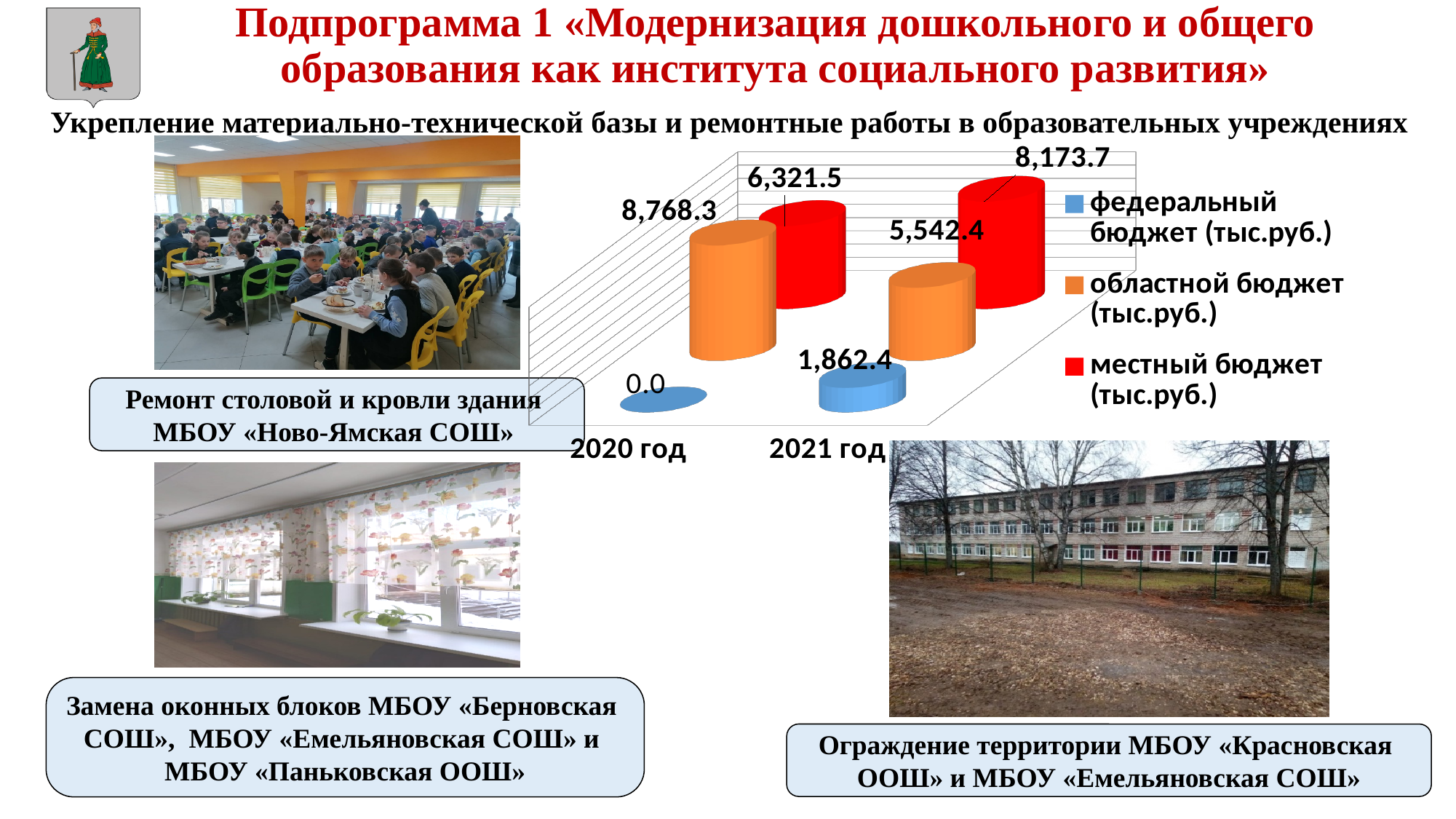
What is the value for федеральный бюджет (тыс.руб.) in 2020 год? 0.0 How many series does the chart legend list? 3 How many year categories are shown on the chart's x axis? 2 What is the value for местный бюджет (тыс.руб.) in 2020 год? 6,321.5 What is the difference between the областной бюджет values for 2020 год and 2021 год? 3,225.9 What is the value for местный бюджет (тыс.руб.) in 2021 год? 8,173.7 Which budget series has the lowest value in 2020 год? федеральный бюджет (тыс.руб.) What is the value for областной бюджет (тыс.руб.) in 2020 год? 8,768.3 Which budget series has the highest value in 2021 год? местный бюджет (тыс.руб.) What kind of chart is shown on the slide? bar chart What is the value for федеральный бюджет (тыс.руб.) in 2021 год? 1,862.4 Which is larger: местный бюджет in 2020 год or местный бюджет in 2021 год? 2021 год